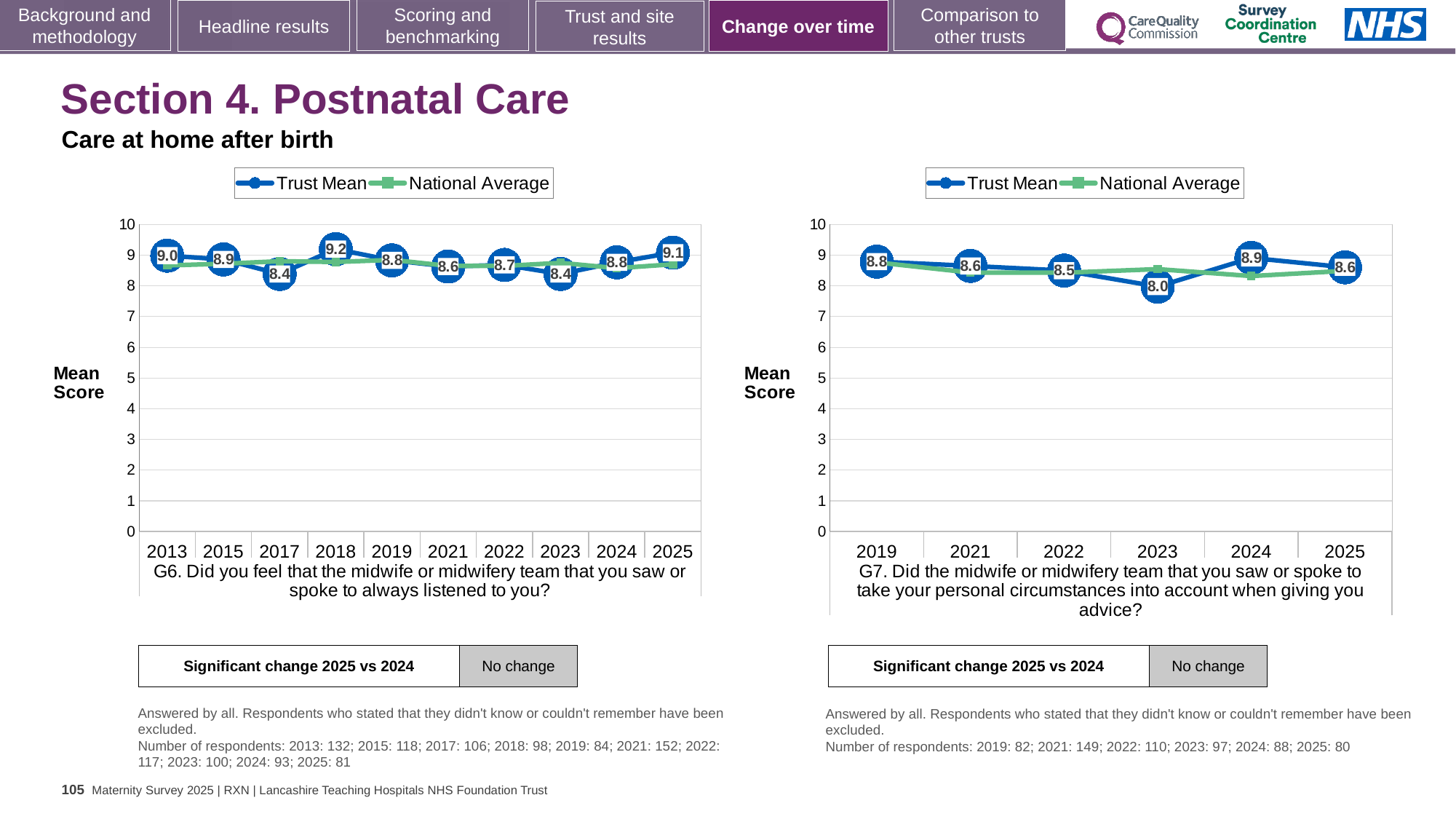
In the G7 chart on the right, what is the difference between the Trust Mean scores for 2024 and 2023? 0.9 In the G6 chart on the left, is the Trust Mean score for 2017 or 2018 larger? 2018 How many series does the legend of the G6 chart on the left list? 2 In the G7 chart on the right, what is the Trust Mean score for 2024? 8.9 In the G6 chart on the left, which year has the highest Trust Mean score? 2018 How many years are shown on the x axis of the G7 chart on the right? 6 In the G7 chart on the right, what is the Trust Mean score for 2023? 8.0 In the G7 chart on the right, which year has the lowest Trust Mean score? 2023 In the G6 chart on the left, what is the Trust Mean score for 2025? 9.1 In the G6 chart on the left, what is the Trust Mean score for 2018? 9.2 In the G7 chart on the right, which year has the highest Trust Mean score? 2024 In the G6 chart on the left, what is the difference between the Trust Mean scores for 2025 and 2024? 0.3